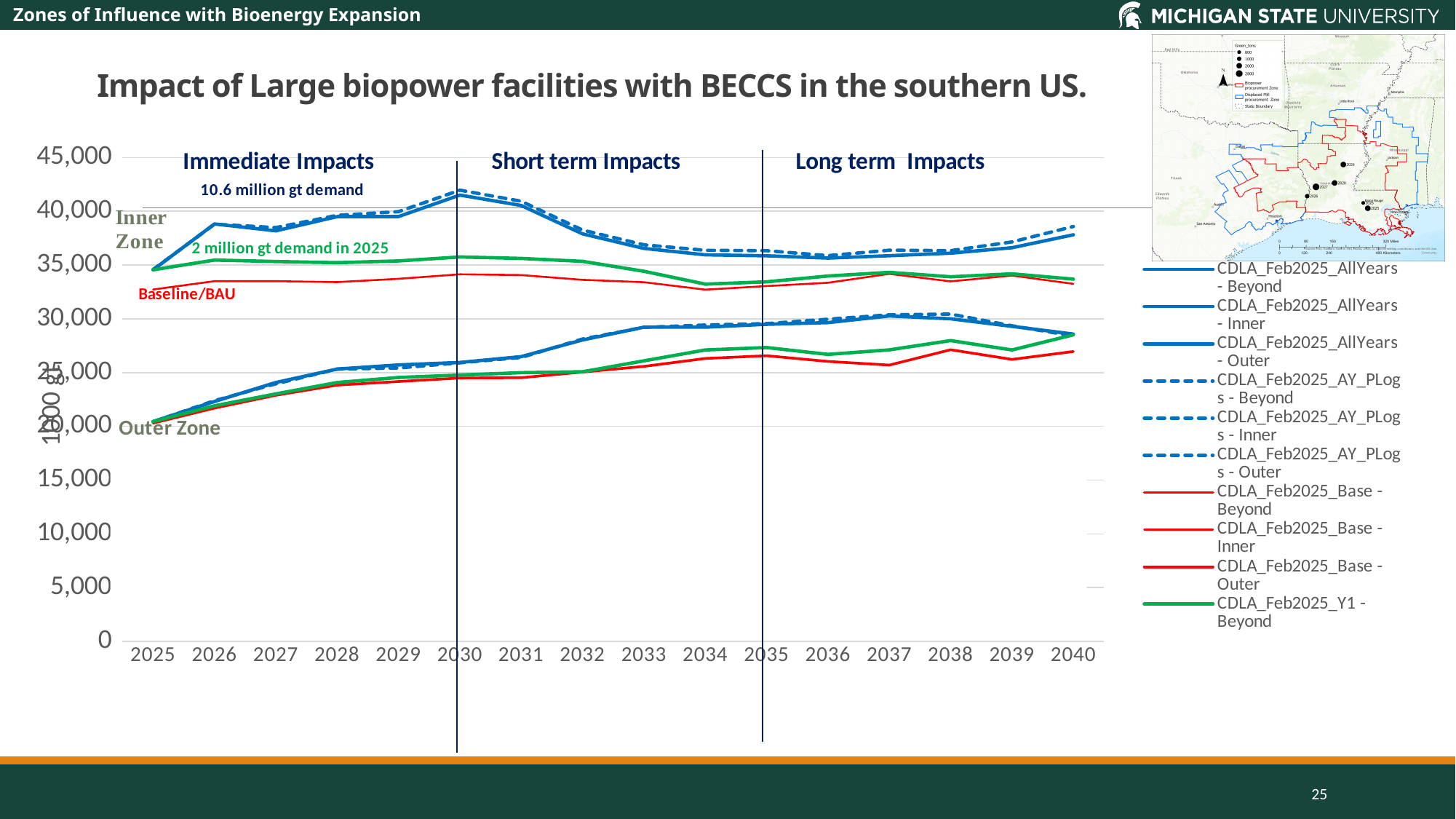
Is the value of the solid blue Inner Zone line (CDLA_Feb2025_AllYears - Inner) in 2030 greater or less than 40,000? greater In 2030, which is higher: the solid blue Inner Zone line or the red Baseline/BAU line? the solid blue Inner Zone line How many years are shown along the x axis of the chart? 16 Does the solid blue Outer Zone line rise or fall from 2025 to 2033? rise In which year does the solid blue Inner Zone line (CDLA_Feb2025_AllYears - Inner) reach its highest value? 2030 Is the value of the solid blue Outer Zone line in 2040 greater or less than 30,000? less Is the value of the red Baseline/BAU line in the upper group in 2030 greater or less than 35,000? less What kind of chart is shown on the slide? line chart What is the highest tick value shown on the y axis of the chart? 45,000 How many series does the chart legend list? 10 What is the first year shown on the x axis of the chart? 2025